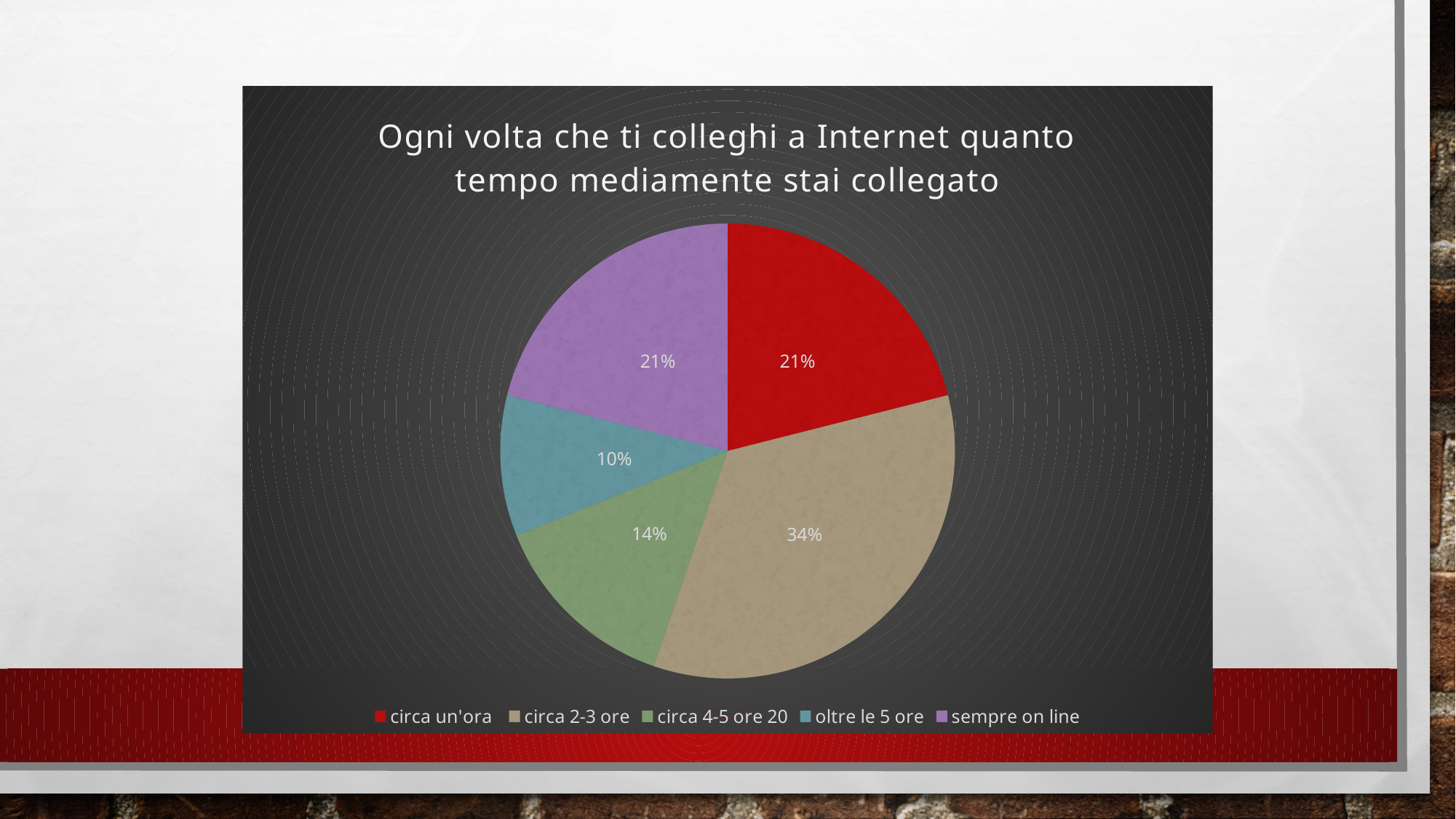
What percentage of the pie is the 'circa un'ora' slice? 21% What is the difference in percentage points between the 'circa 2-3 ore' slice and the 'oltre le 5 ore' slice? 24 What percentage of the pie is the 'circa 2-3 ore' slice? 34% Which category has the largest slice of the pie? circa 2-3 ore What percentage of the pie is the 'sempre on line' slice? 21% Which category has the smallest slice of the pie? oltre le 5 ore What is the title of the chart? Ogni volta che ti colleghi a Internet quanto tempo mediamente stai collegato Which slice is larger, 'circa 4-5 ore 20' or 'sempre on line'? sempre on line How many categories does the legend list? 5 What type of chart is shown on the slide? pie chart